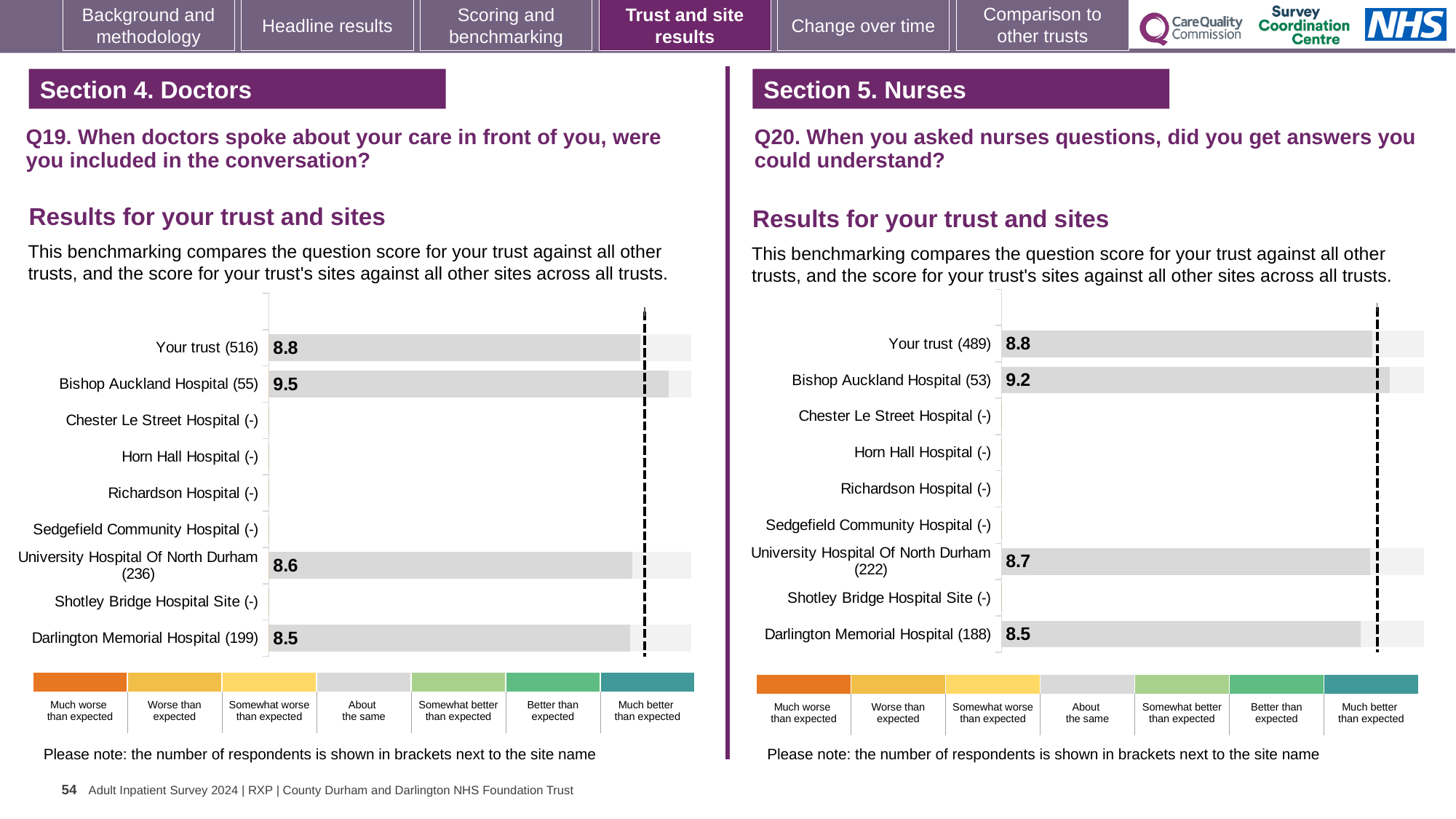
In the Q19 chart (left), what is the difference between the scores for Bishop Auckland Hospital and Darlington Memorial Hospital? 1.0 In the Q20 chart (right), what is the score for Darlington Memorial Hospital? 8.5 In the Q19 chart (left), which site has the highest score? Bishop Auckland Hospital In the Q20 chart (right), which site with a plotted score has the lowest score? Darlington Memorial Hospital In the Q19 chart (left), how many respondents are shown in brackets for Darlington Memorial Hospital? 199 In the Q20 chart (right), which has the higher score: Your trust or University Hospital Of North Durham? Your trust In the Q20 chart (right), what is the difference between the scores for Bishop Auckland Hospital and Your trust? 0.4 In the Q19 chart (left), what is the score for Bishop Auckland Hospital? 9.5 In the Q19 chart (left), what is the score for Your trust? 8.8 In the Q20 chart (right), what is the score for University Hospital Of North Durham? 8.7 What kind of chart is used for the Q20 results (right)? Bar chart How many site/trust categories are listed on the y axis of the Q19 chart (left)? 9